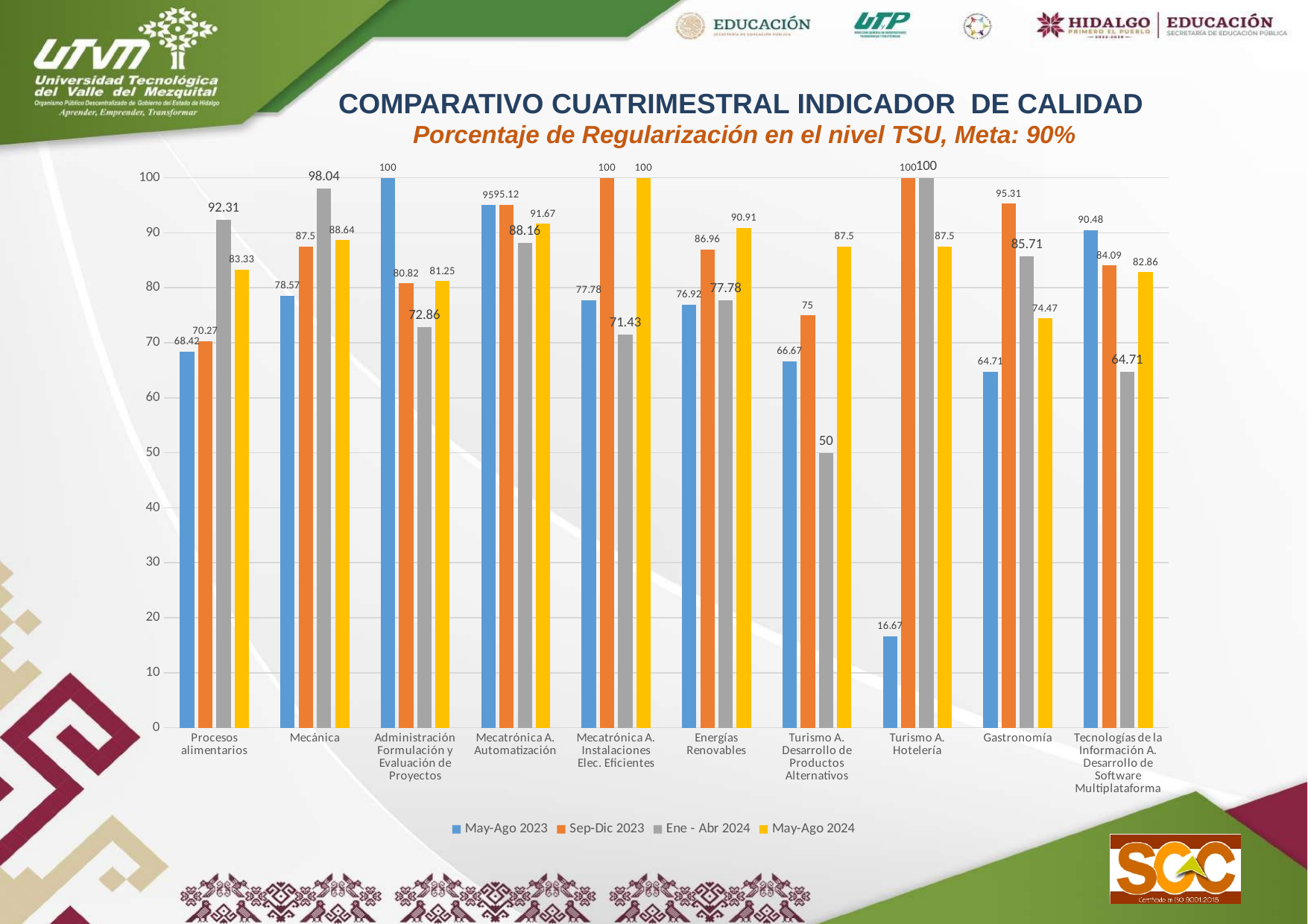
Which is larger for Energías Renovables: the Sep-Dic 2023 value or the May-Ago 2024 value? May-Ago 2024 What type of chart is shown on the slide? bar chart Which category has the lowest value in the May-Ago 2023 series? Turismo A. Hotelería How many categories (programs) are shown on the x axis? 10 What is the value for Mecánica in the Ene - Abr 2024 series? 98.04 Is the Ene - Abr 2024 value for Procesos alimentarios greater or less than 90? greater Which category has the lowest value in the Ene - Abr 2024 series? Turismo A. Desarrollo de Productos Alternativos How many series does the legend list? 4 What is the value for Turismo A. Hotelería in the May-Ago 2023 series? 16.67 What is the difference between the May-Ago 2024 and May-Ago 2023 values for Turismo A. Desarrollo de Productos Alternativos? 20.83 What target (Meta) is stated in the chart subtitle? 90% What is the value for Gastronomía in the Sep-Dic 2023 series? 95.31